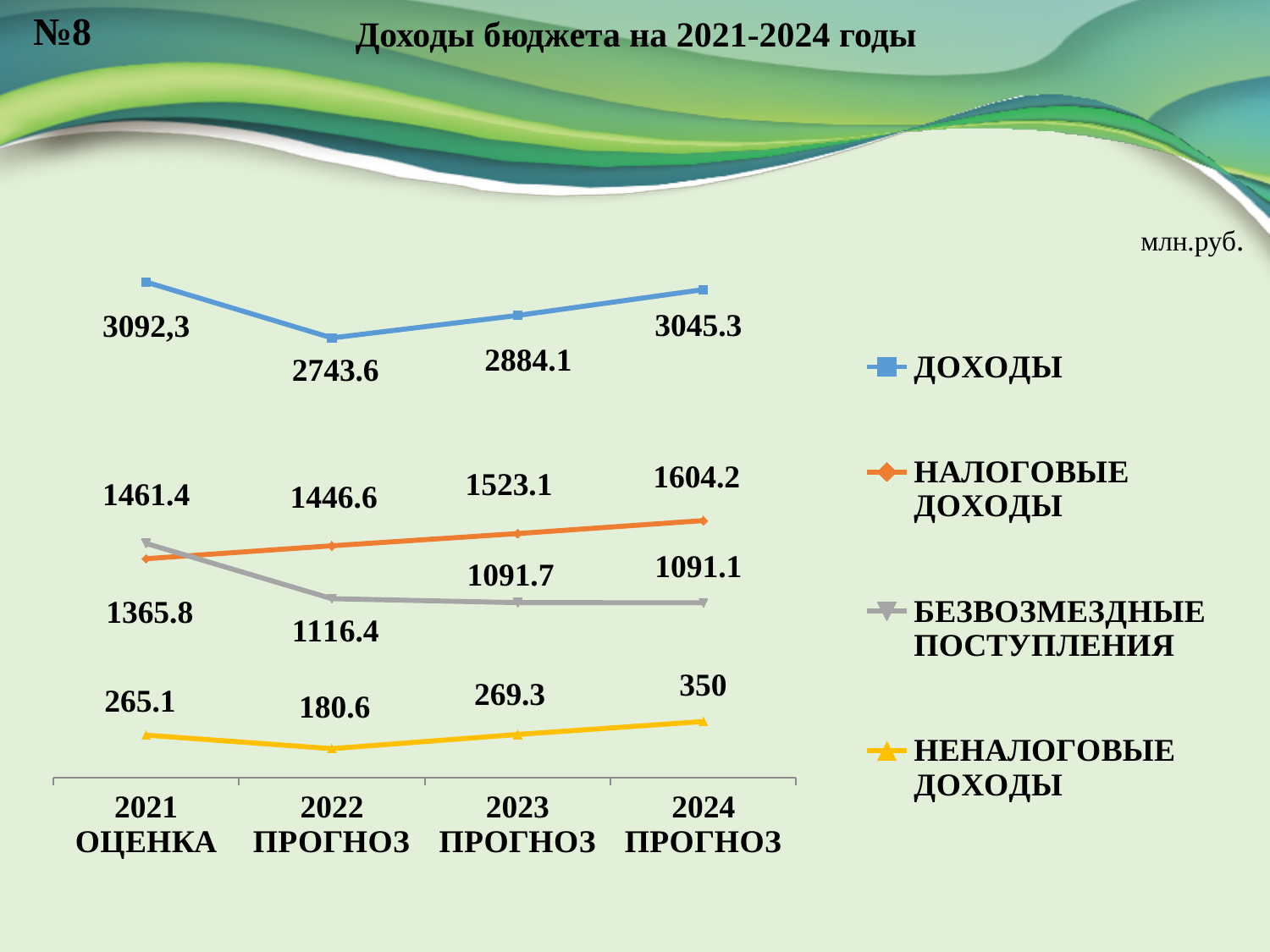
Which is larger in 2021 ОЦЕНКА: НАЛОГОВЫЕ ДОХОДЫ or БЕЗВОЗМЕЗДНЫЕ ПОСТУПЛЕНИЯ? БЕЗВОЗМЕЗДНЫЕ ПОСТУПЛЕНИЯ What is the value of ДОХОДЫ for 2022 ПРОГНОЗ? 2743.6 What is the value of НЕНАЛОГОВЫЕ ДОХОДЫ for 2023 ПРОГНОЗ? 269.3 What is the value of НАЛОГОВЫЕ ДОХОДЫ for 2024 ПРОГНОЗ? 1604.2 How many series does the legend list? 4 Do the values of НАЛОГОВЫЕ ДОХОДЫ rise or fall from 2021 to 2024? Rise What is the difference between НАЛОГОВЫЕ ДОХОДЫ in 2024 ПРОГНОЗ and in 2021 ОЦЕНКА? 238.4 What is the value of БЕЗВОЗМЕЗДНЫЕ ПОСТУПЛЕНИЯ for 2021 ОЦЕНКА? 1461.4 What kind of chart is shown on the slide? Line chart What is the difference between НЕНАЛОГОВЫЕ ДОХОДЫ in 2024 ПРОГНОЗ and in 2022 ПРОГНОЗ? 169.4 In which year is the value of НЕНАЛОГОВЫЕ ДОХОДЫ highest? 2024 ПРОГНОЗ In which year is the value of ДОХОДЫ lowest? 2022 ПРОГНОЗ